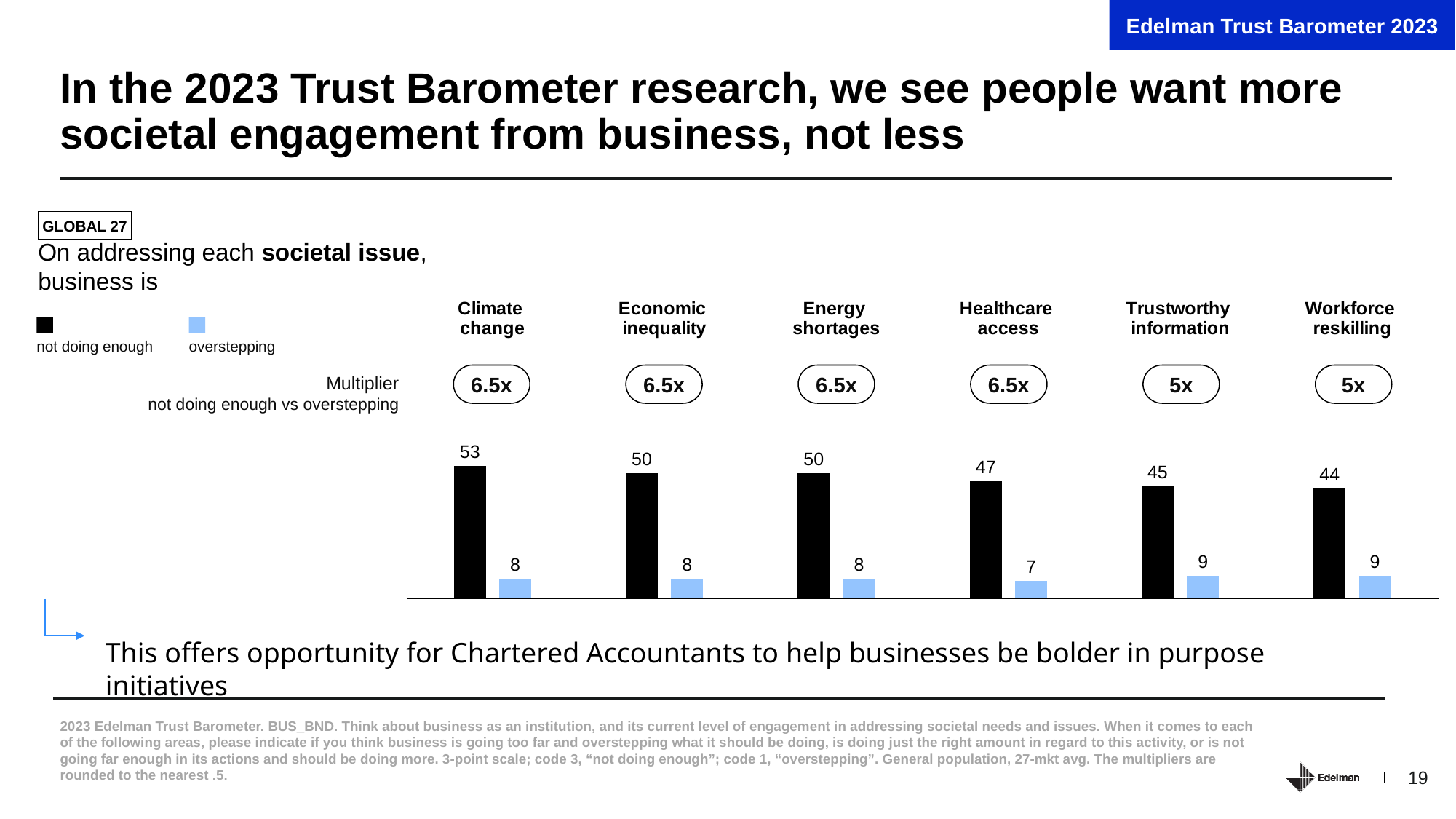
What is the 'overstepping' value for Healthcare access? 7 How many societal issues are shown in the chart? 6 How many series does the legend list? 2 What is the 'not doing enough' value for Climate change? 53 Which societal issue has the highest 'not doing enough' value? Climate change Do the 'not doing enough' values rise or fall from Climate change to Workforce reskilling? Fall What multiplier is shown for Trustworthy information? 5x Which societal issue has the lowest 'overstepping' value? Healthcare access What is the 'not doing enough' value for Workforce reskilling? 44 What is the difference between the 'not doing enough' and 'overstepping' values for Economic inequality? 42 Which is larger: the 'not doing enough' value for Trustworthy information or for Workforce reskilling? Trustworthy information What kind of chart is shown on the slide? Bar chart